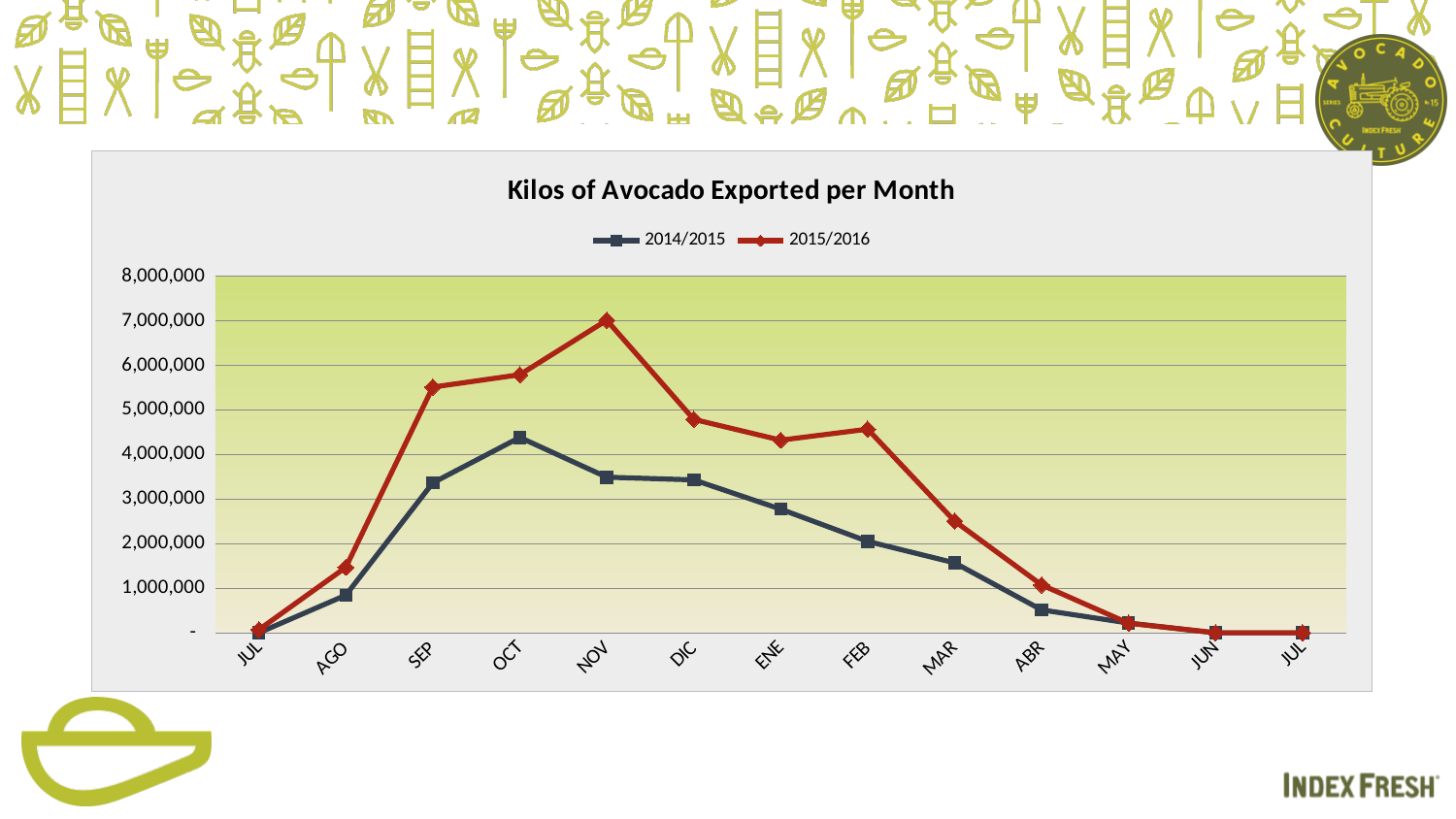
Does the 2015/2016 series rise or fall from NOV to MAY? fall What kind of chart is shown on the slide? line chart Is the 2014/2015 value for FEB greater or less than 3,000,000? less Is the 2014/2015 value for OCT greater or less than 4,000,000? greater Is the 2015/2016 value for SEP greater or less than 5,000,000? greater How many months are plotted along the x axis? 13 In which month does the 2014/2015 series reach its highest value? OCT In which month does the 2015/2016 series reach its highest value? NOV How many series does the legend list? 2 In NOV, which series has the larger value, 2014/2015 or 2015/2016? 2015/2016 Which colour is used for the 2015/2016 series? red What is the title of the chart? Kilos of Avocado Exported per Month